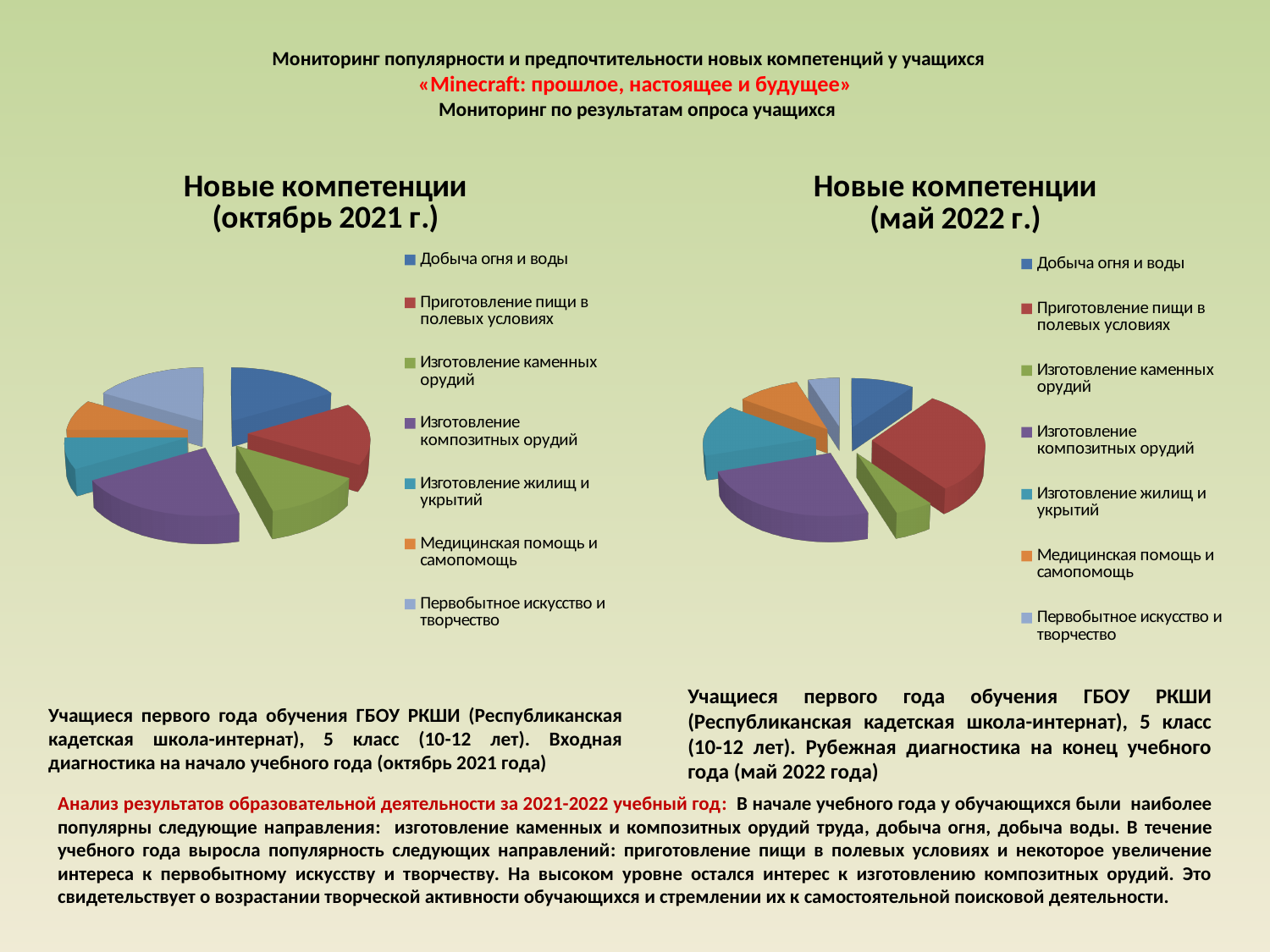
What kind of chart is the 'Новые компетенции (май 2022 г.)' chart? pie chart In the 'Новые компетенции (май 2022 г.)' chart, which category has the largest slice? Приготовление пищи в полевых условиях What kind of chart is the 'Новые компетенции (октябрь 2021 г.)' chart? pie chart How many entries does the legend of the 'Новые компетенции (май 2022 г.)' chart list? 7 In the 'Новые компетенции (октябрь 2021 г.)' chart, which slice is larger: 'Изготовление композитных орудий' or 'Медицинская помощь и самопомощь'? Изготовление композитных орудий In the 'Новые компетенции (май 2022 г.)' chart, which colour represents 'Добыча огня и воды'? blue In the 'Новые компетенции (май 2022 г.)' chart, which slice is larger: 'Приготовление пищи в полевых условиях' or 'Изготовление каменных орудий'? Приготовление пищи в полевых условиях What is the title of the left chart on the slide? Новые компетенции (октябрь 2021 г.) How many slices does the 'Новые компетенции (октябрь 2021 г.)' pie chart have? 7 In the 'Новые компетенции (октябрь 2021 г.)' chart, which category has the largest slice? Изготовление композитных орудий